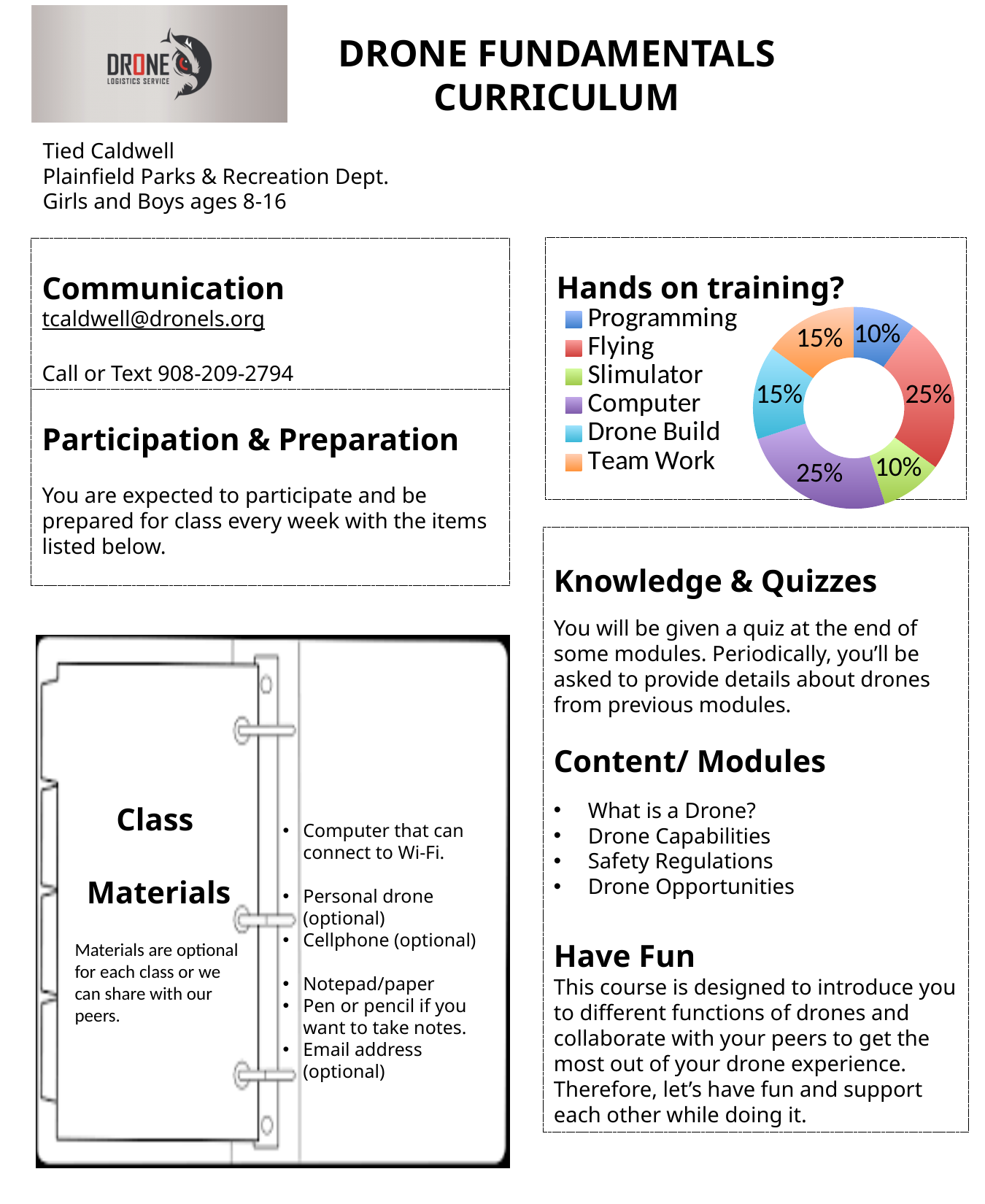
In the 'Hands on training?' chart, what is the difference between Drone Build and Slimulator? 5% What share of the 'Hands on training?' chart is Flying? 25% What is the value for Computer in the 'Hands on training?' chart? 25% What is the value for Slimulator in the 'Hands on training?' chart? 10% What percentage does Programming account for in the 'Hands on training?' chart? 10% In the 'Hands on training?' chart, what is the difference between Computer and Programming? 15% In the 'Hands on training?' chart, which colour represents Team Work? Orange How many categories does the 'Hands on training?' chart show? 6 What is the value for Team Work in the 'Hands on training?' chart? 15% In the 'Hands on training?' chart, which is larger: Flying or Slimulator? Flying What type of chart is 'Hands on training?'? Doughnut chart What is the value for Drone Build in the 'Hands on training?' chart? 15%